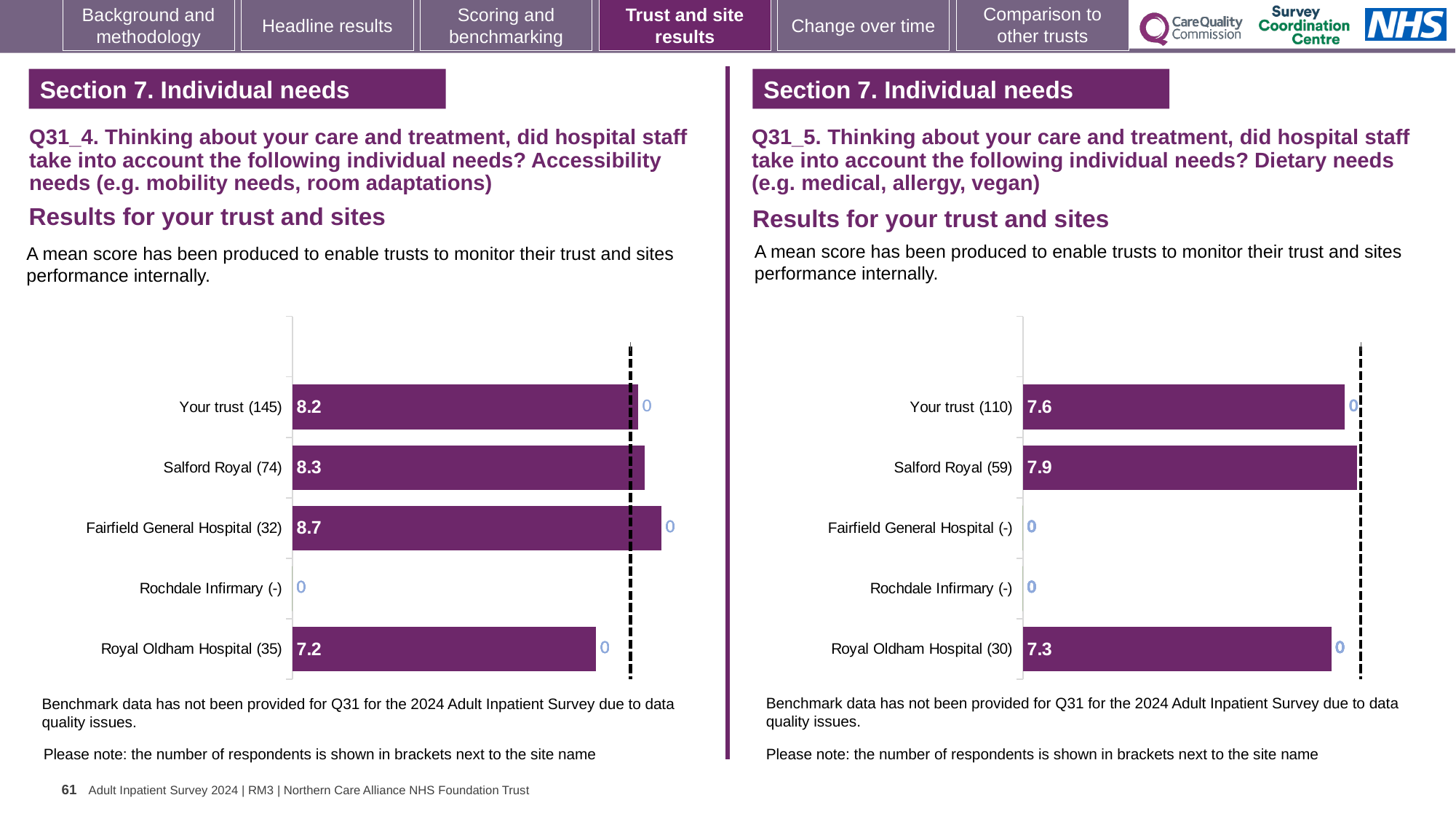
In the Q31_4 Accessibility needs chart on the left, which site has the highest mean score? Fairfield General Hospital How many site categories are listed on the y axis of the Q31_4 Accessibility needs chart on the left? 5 In the Q31_5 Dietary needs chart on the right, which is larger, the mean score for Your trust or for Royal Oldham Hospital? Your trust In the Q31_4 Accessibility needs chart on the left, what is the mean score for Fairfield General Hospital? 8.7 In the Q31_4 Accessibility needs chart on the left, which site with a plotted bar has the lowest mean score? Royal Oldham Hospital In the Q31_4 Accessibility needs chart on the left, what is the mean score for Your trust? 8.2 In the Q31_4 Accessibility needs chart on the left, what is the difference between the mean scores for Fairfield General Hospital and Royal Oldham Hospital? 1.5 In the Q31_5 Dietary needs chart on the right, what is the difference between the mean scores for Salford Royal and Royal Oldham Hospital? 0.6 What kind of chart is used for the Q31_5 Dietary needs results on the right? Bar chart In the Q31_5 Dietary needs chart on the right, what is the mean score for Your trust? 7.6 In the Q31_5 Dietary needs chart on the right, what is the mean score for Salford Royal? 7.9 In the Q31_5 Dietary needs chart on the right, which site has the highest mean score? Salford Royal